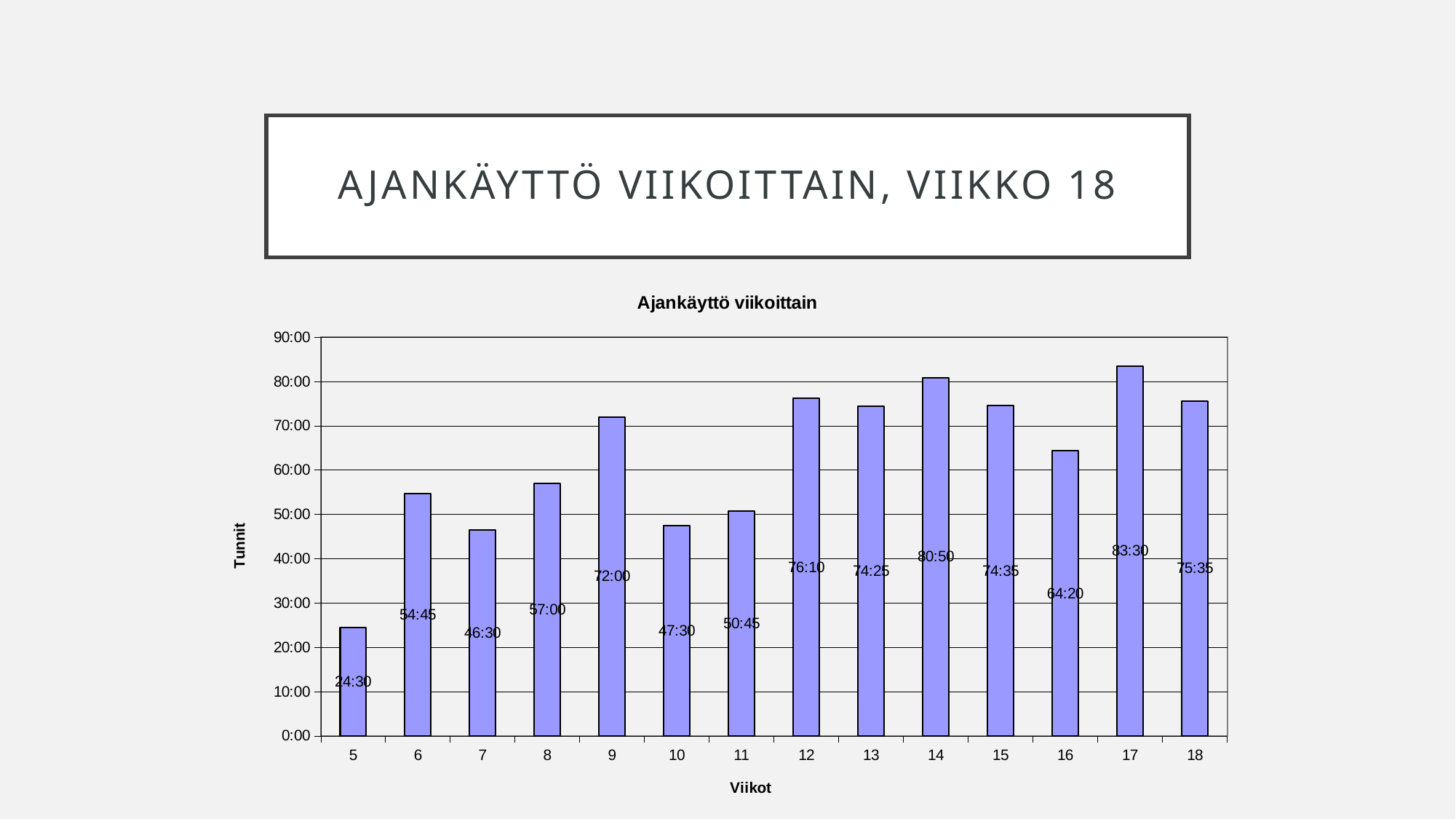
What is the label of the y axis? Tunnit What is the difference between the values for week 17 and week 5? 59:00 What is the value for week 7? 46:30 What is the value for week 9? 72:00 Is the value for week 16 greater or less than 60:00? greater Which week has the highest value? 17 Which week has the lowest value? 5 What kind of chart is shown? bar chart Which is larger, the value for week 12 or week 13? week 12 What is the value for week 14? 80:50 How many weeks are shown on the x axis? 14 What is the difference between the values for week 9 and week 8? 15:00